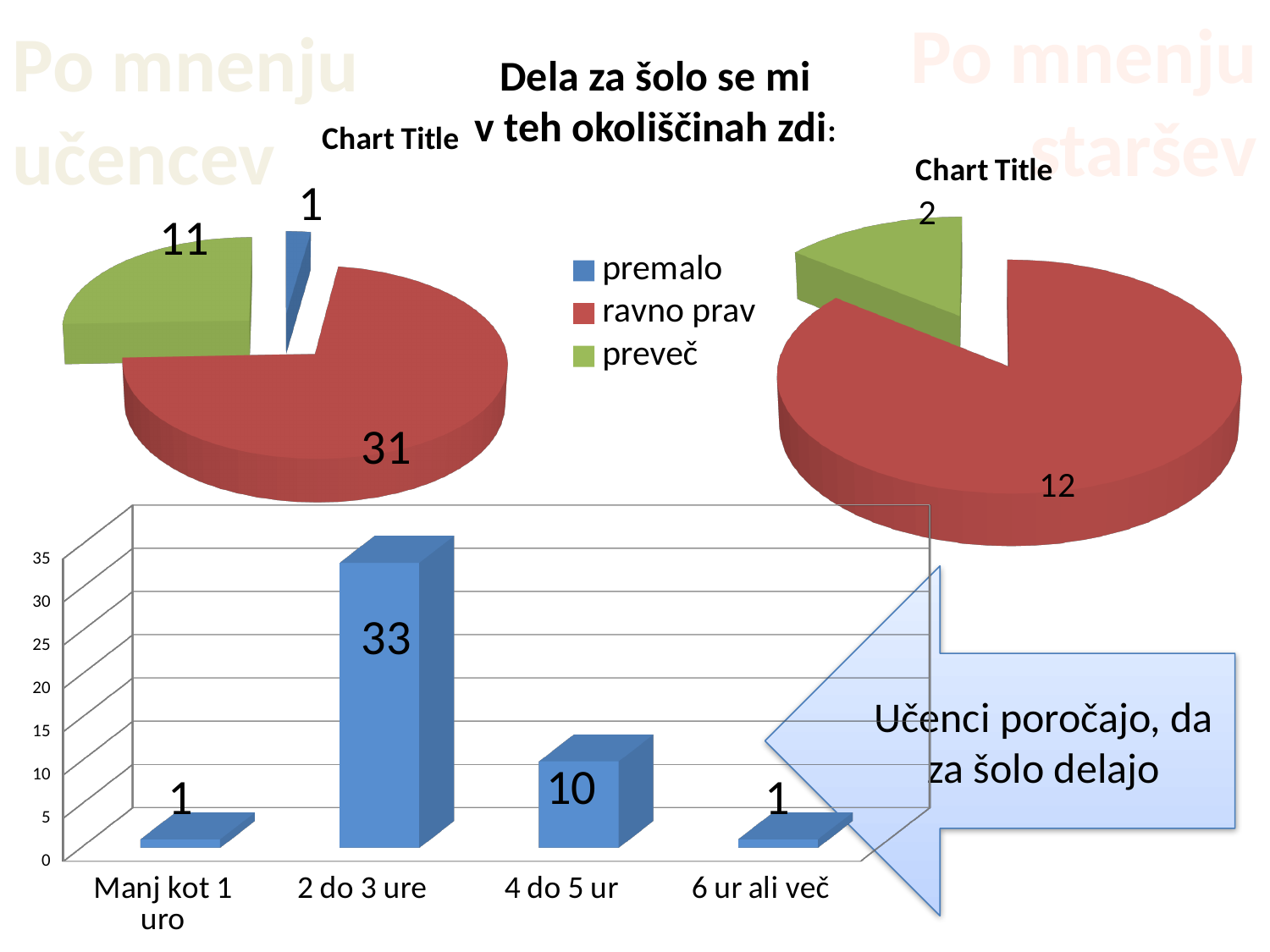
In the right pie chart, what is the value for 'ravno prav'? 12 In the right pie chart, what is the value for 'preveč'? 2 How many categories are shown on the x axis of the bar chart at the bottom? 4 In the bar chart at the bottom, what is the value for '4 do 5 ur'? 10 In the left pie chart, what is the difference between the 'ravno prav' and 'preveč' values? 20 In the left pie chart, what is the value for 'ravno prav'? 31 How many entries does the legend between the two pie charts list? 3 In the left pie chart, which category has the smallest slice? premalo In the bar chart at the bottom, which category has the highest value? 2 do 3 ure In the left pie chart, what is the value for 'preveč'? 11 In the bar chart at the bottom, what is the value for '2 do 3 ure'? 33 In the right pie chart, which category has the largest slice? ravno prav